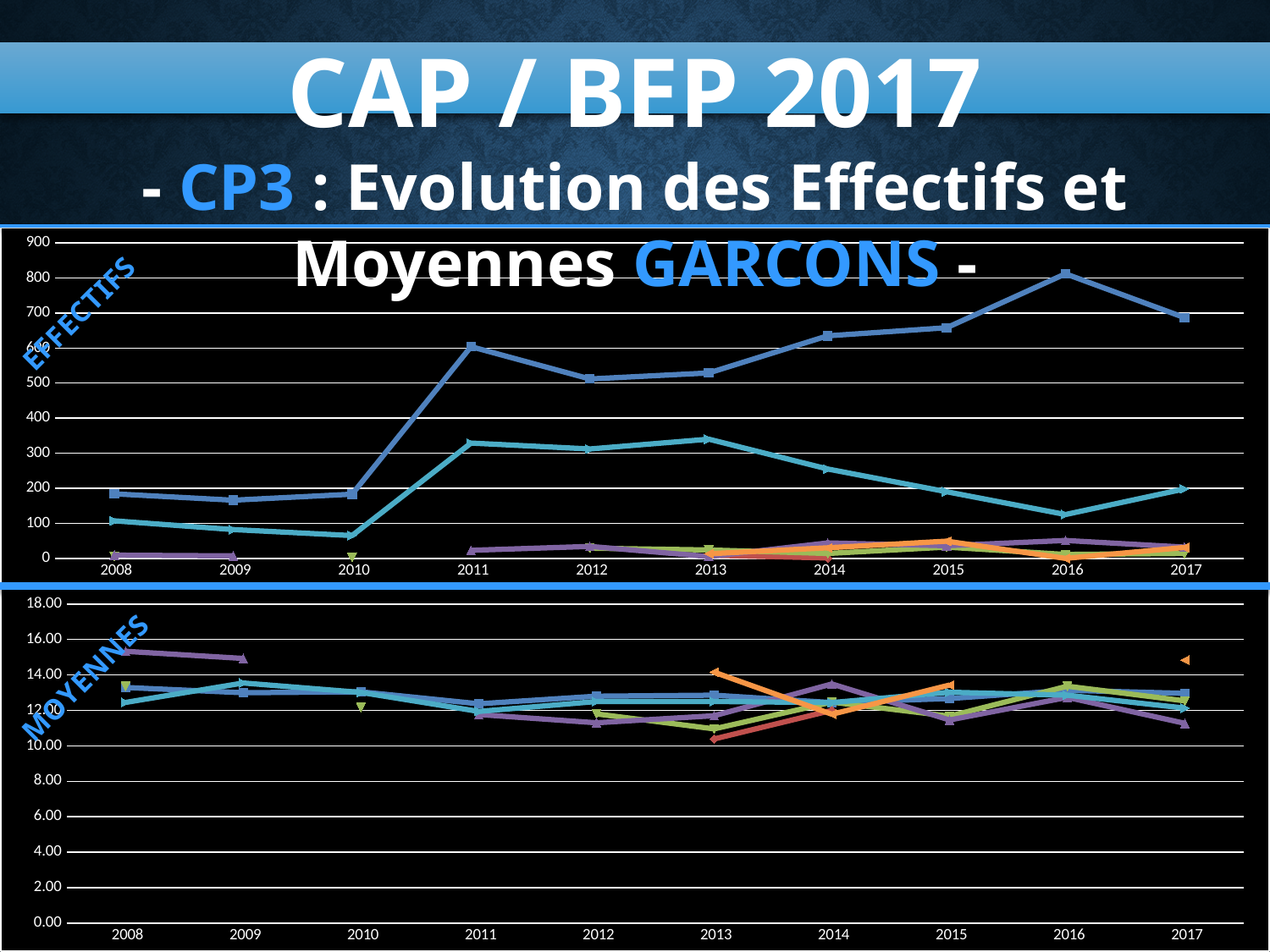
How many years are shown on the x axis of the MOYENNES chart? 10 In the EFFECTIFS chart, is the value of the dark blue line in 2008 greater or less than 300? less In the EFFECTIFS chart, is the value of the dark blue line in 2011 greater or less than 500? greater In the MOYENNES chart, is the value of the purple line in 2008 greater or less than 14.00? greater What is the first year shown on the x axis of the EFFECTIFS chart? 2008 In the EFFECTIFS chart, in which year does the dark blue (highest) line reach its highest value? 2016 How many years are shown on the x axis of the EFFECTIFS chart? 10 In the EFFECTIFS chart, does the dark blue line rise or fall between 2016 and 2017? fall What kind of chart is the bottom chart labelled MOYENNES? line chart In the EFFECTIFS chart, does the dark blue line rise or fall between 2010 and 2011? rise What kind of chart is the top chart labelled EFFECTIFS? line chart